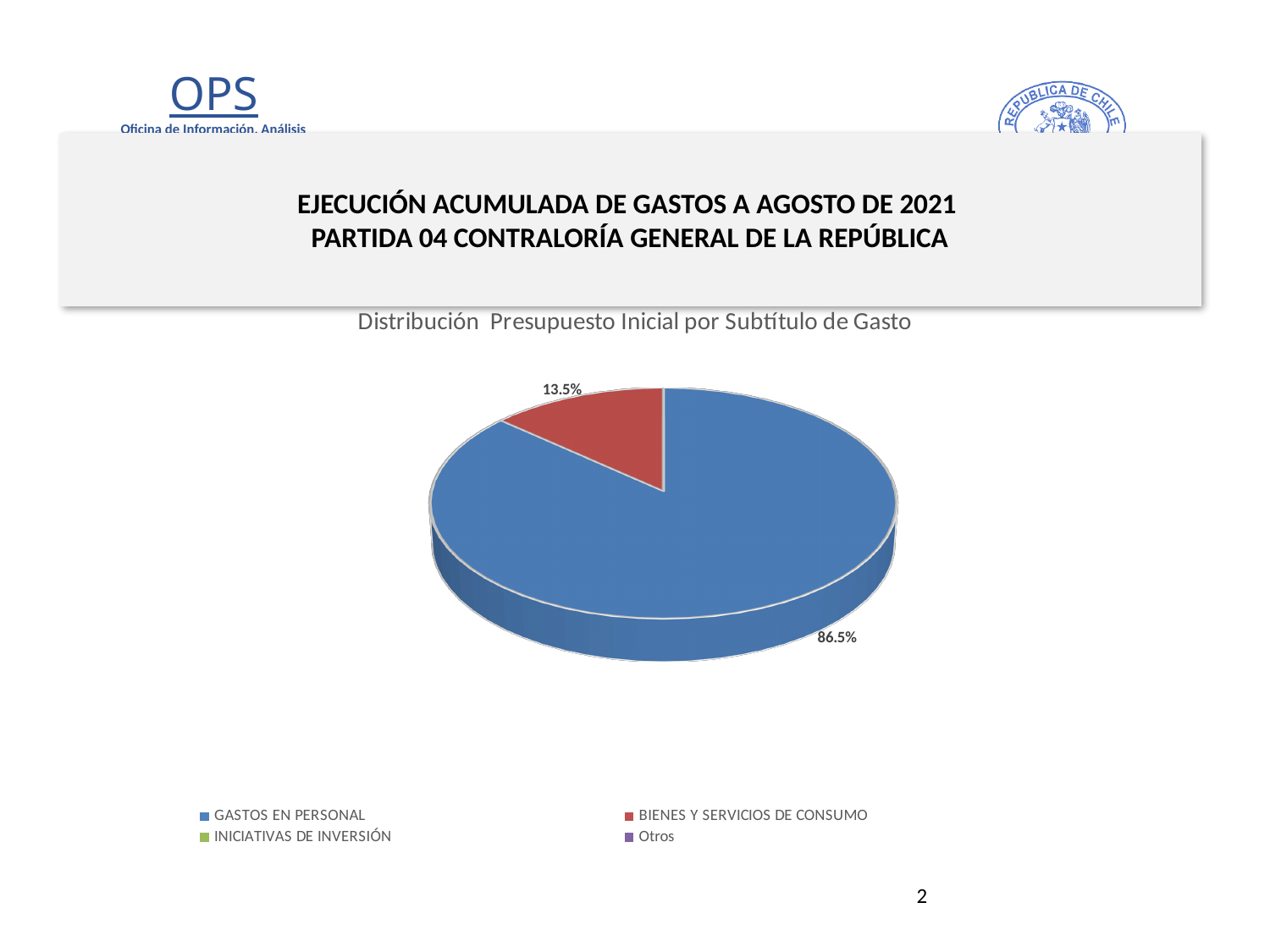
What share of the pie does GASTOS EN PERSONAL represent? 86.5% What colour is the slice for BIENES Y SERVICIOS DE CONSUMO? Red What is the difference in percentage points between the GASTOS EN PERSONAL share and the BIENES Y SERVICIOS DE CONSUMO share? 73.0 What kind of chart is shown on the slide? Pie chart Which of the labelled slices has the smallest share of the pie? BIENES Y SERVICIOS DE CONSUMO How many entries does the chart legend list? 4 How many slices with data labels are visible in the pie? 2 Which category has the largest share of the pie? GASTOS EN PERSONAL What is the title of the chart? Distribución Presupuesto Inicial por Subtítulo de Gasto What share of the pie does BIENES Y SERVICIOS DE CONSUMO represent? 13.5% Which is larger, the share for GASTOS EN PERSONAL or the share for BIENES Y SERVICIOS DE CONSUMO? GASTOS EN PERSONAL